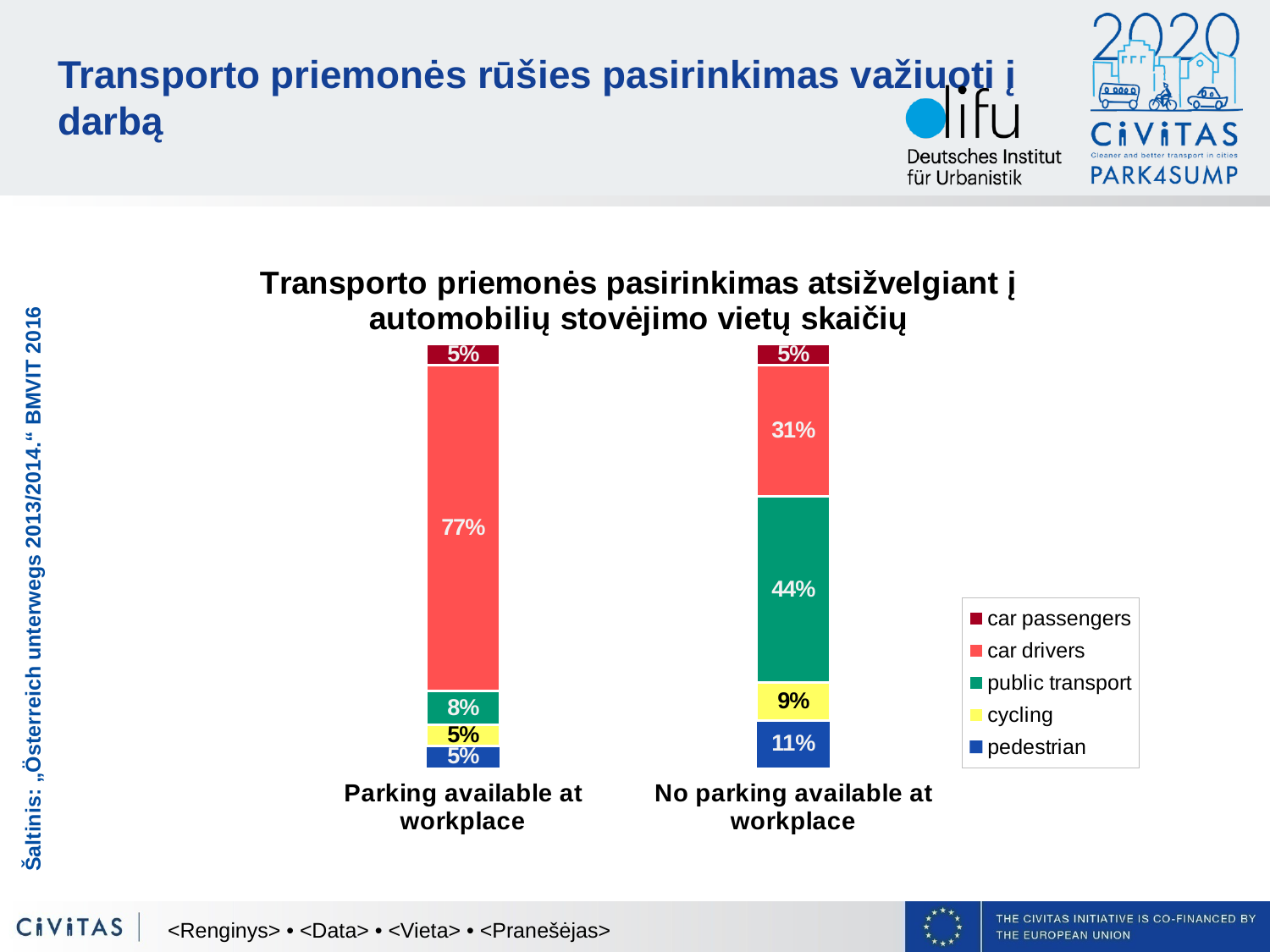
Which is larger: the public transport share for 'Parking available at workplace' or for 'No parking available at workplace'? No parking available at workplace How many series does the legend list? 5 Which colour represents car passengers in the legend? dark red What kind of chart is shown on the slide? stacked bar chart What is the total of the 'Parking available at workplace' stacked bar? 100% What is the share of cycling for 'Parking available at workplace'? 5% Which series has the largest share in the 'No parking available at workplace' bar? public transport What is the share of public transport for 'No parking available at workplace'? 44% What is the share of car drivers for 'Parking available at workplace'? 77% How many categories (bars) are shown on the x axis? 2 What is the share of pedestrians for 'No parking available at workplace'? 11% What is the difference between the car drivers share for 'Parking available at workplace' and for 'No parking available at workplace'? 46%